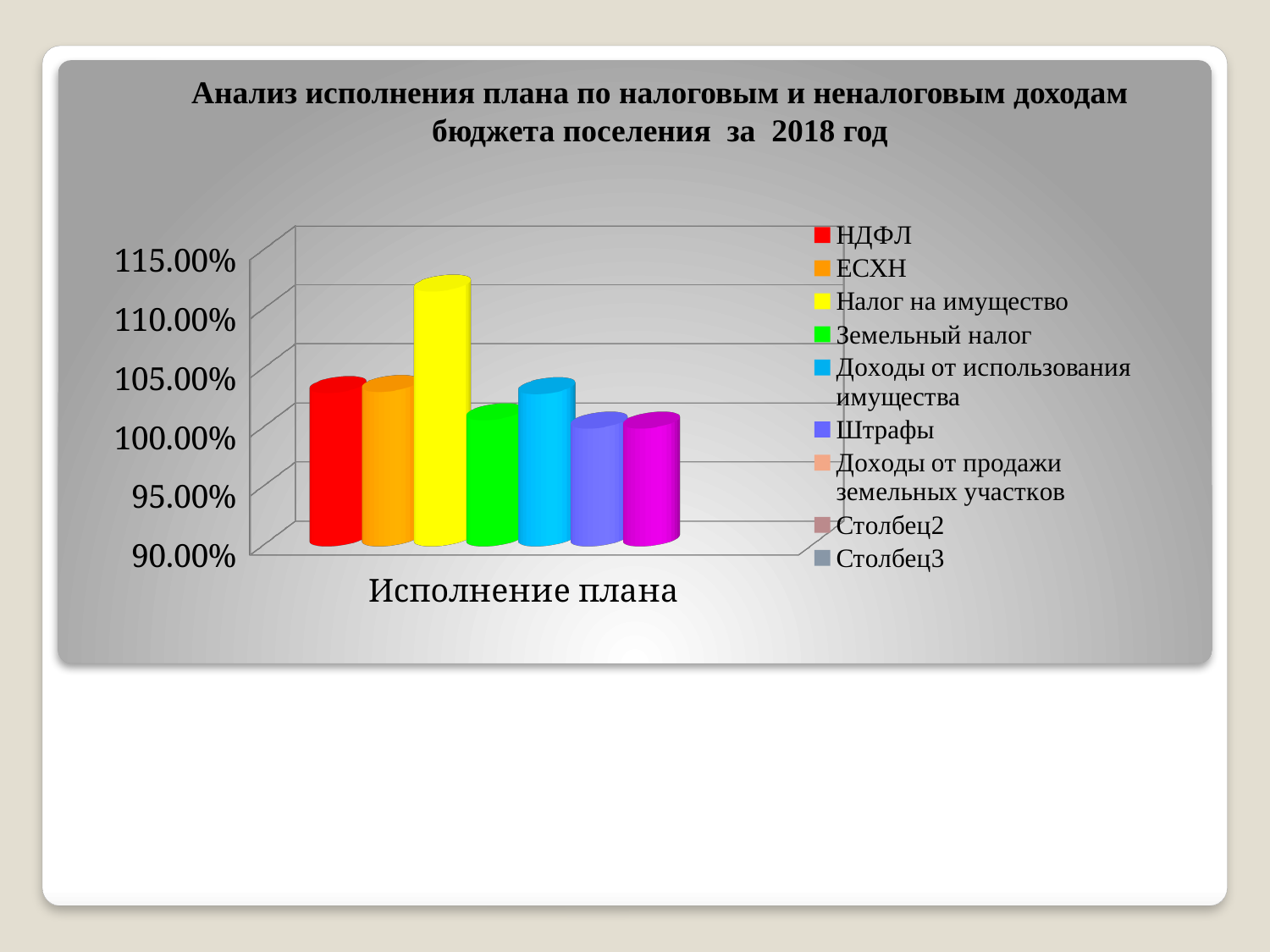
Is the value for Земельный налог greater or less than 105.00%? less What colour is the bar for Налог на имущество? yellow Is the value for Штрафы greater or less than 105.00%? less What kind of chart is shown on the slide? bar chart Is the value for НДФЛ greater or less than 100.00%? greater How many entries does the chart legend list? 9 How many bars are plotted in the chart? 7 Which is larger, the value for Налог на имущество or the value for Земельный налог? Налог на имущество What is the title of the chart? Анализ исполнения плана по налоговым и неналоговым доходам бюджета поселения за 2018 год Which is larger, the value for НДФЛ or the value for Штрафы? НДФЛ Which category has the highest bar in the chart? Налог на имущество